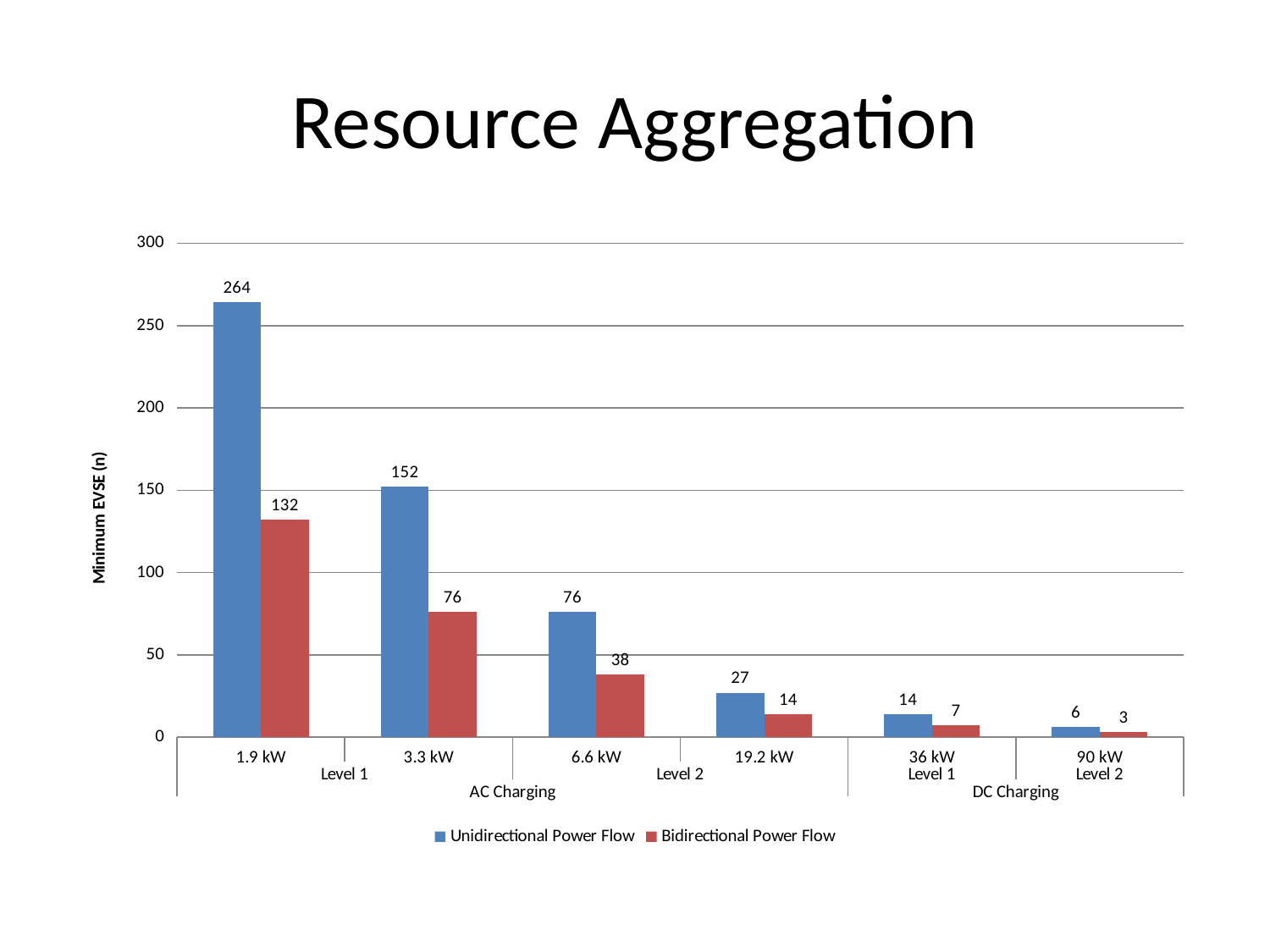
How many kW categories are shown on the x axis? 6 Do the Unidirectional Power Flow values rise or fall from left to right along the x axis? Fall What is the Unidirectional Power Flow value for 1.9 kW? 264 What is the Bidirectional Power Flow value for 90 kW? 3 Which category has the highest Unidirectional Power Flow value? 1.9 kW What kind of chart is shown on the slide? Bar chart What is the label of the y axis? Minimum EVSE (n) How many series does the legend list? 2 Which is larger: the Unidirectional Power Flow value for 19.2 kW or the Bidirectional Power Flow value for 6.6 kW? Bidirectional Power Flow value for 6.6 kW Which category has the lowest Bidirectional Power Flow value? 90 kW What is the Bidirectional Power Flow value for 6.6 kW? 38 What is the difference between the Unidirectional and Bidirectional Power Flow values for 3.3 kW? 76